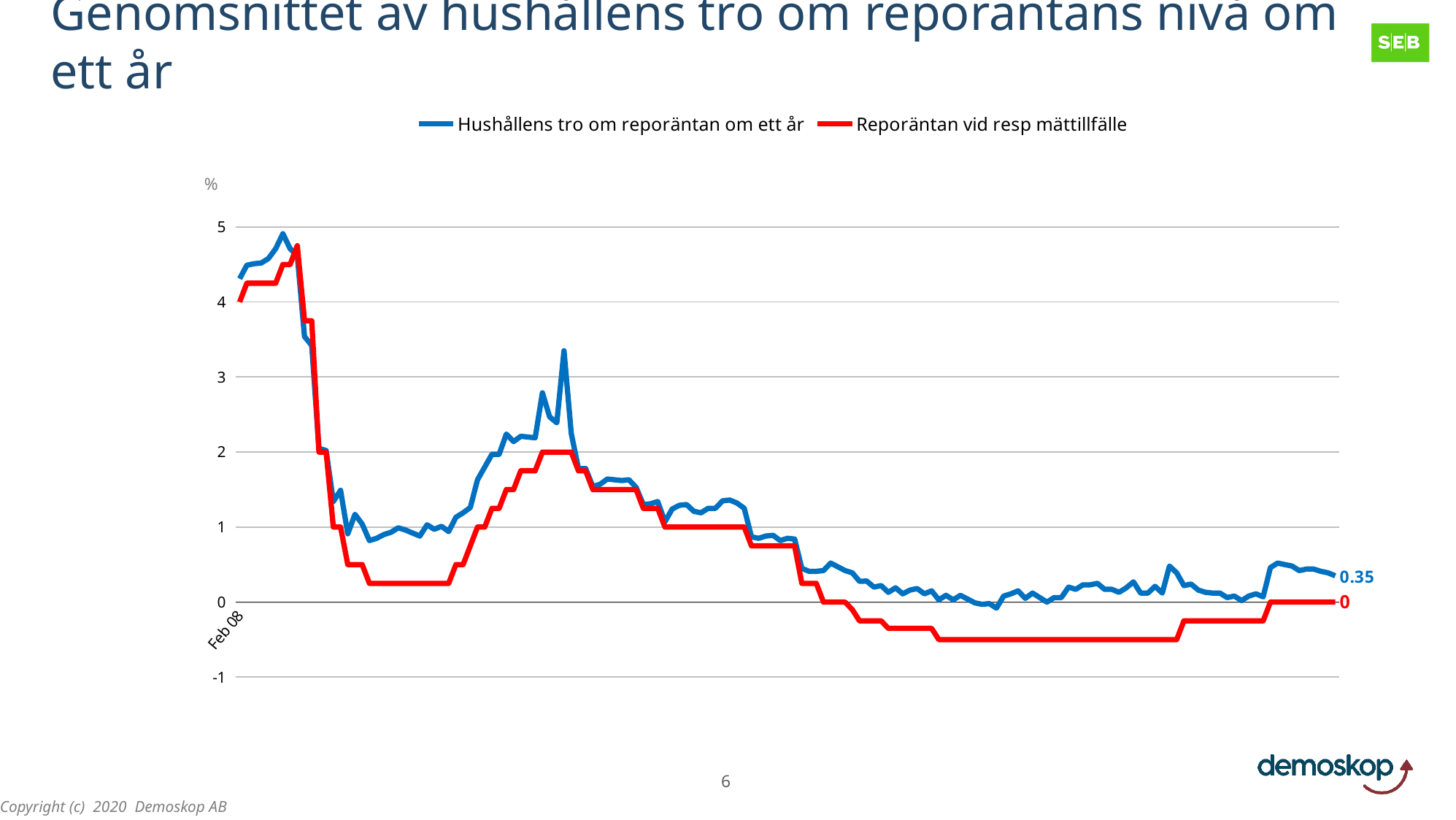
How many series does the legend list? 2 What is the final labelled value of the series 'Hushållens tro om reporäntan om ett år'? 0.35 What is the difference between the final labelled values of the two series? 0.35 Is the lowest value of the red series 'Reporäntan vid resp mättillfälle' greater or less than 0? less Is the value of the blue series at Feb 08 greater or less than 4? greater At the right end of the chart, which series has the higher value? Hushållens tro om reporäntan om ett år What is the final labelled value of the series 'Reporäntan vid resp mättillfälle'? 0 What is the first x-axis label shown on the chart? Feb 08 What unit is shown on the y axis of the chart? % Overall, do the values of the series 'Reporäntan vid resp mättillfälle' rise or fall from left to right across the chart? fall What kind of chart is shown on the slide? line chart Is the peak value of the blue series 'Hushållens tro om reporäntan om ett år' greater or less than 4? greater